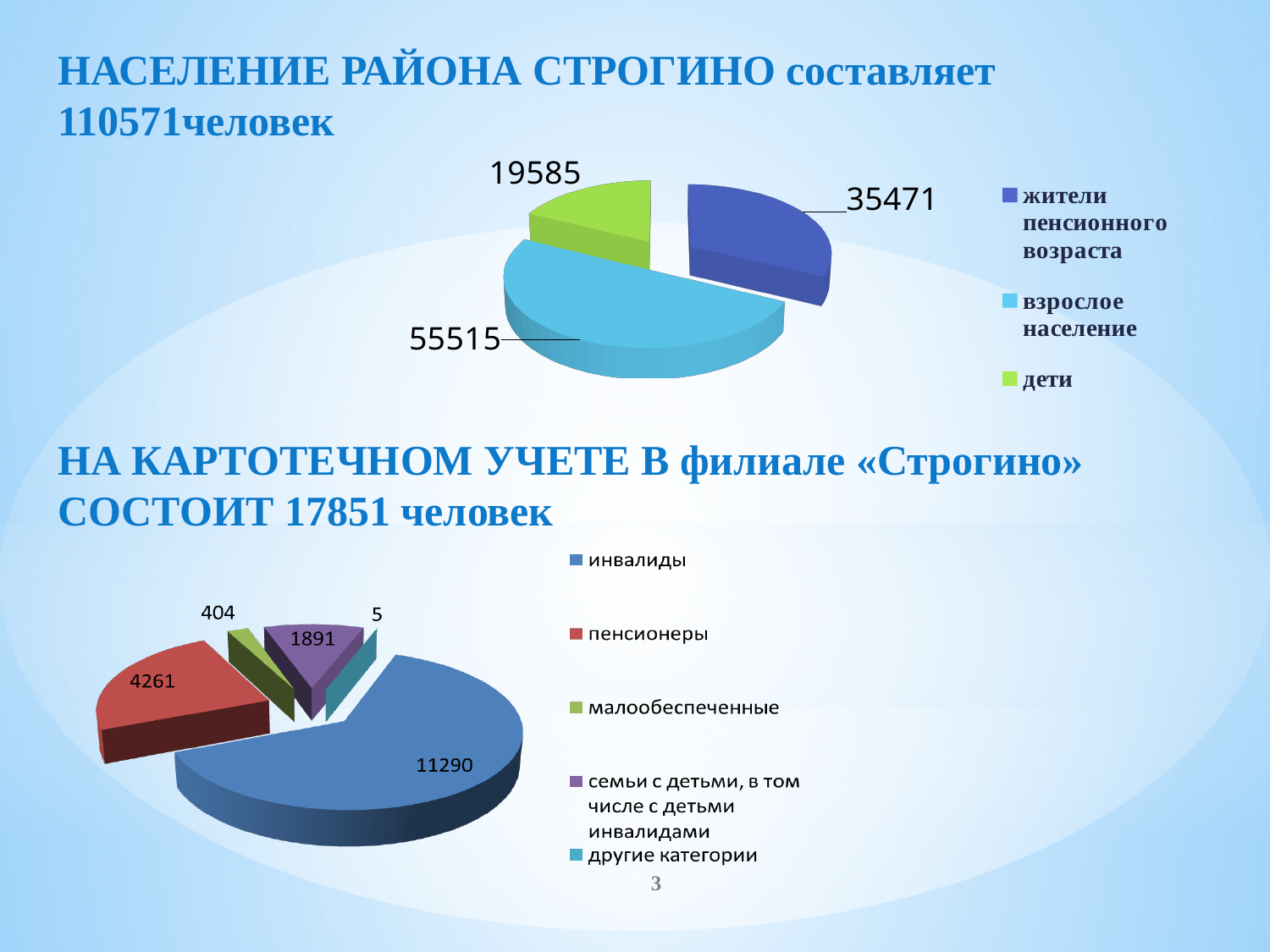
What type of chart is used for the population of Strogino district at the top of the slide? pie chart In the top pie chart (population of Strogino district), how many categories does the legend list? 3 In the top pie chart (population of Strogino district), what is the difference between жители пенсионного возраста and дети? 15886 In the bottom pie chart (people registered at the Strogino branch), how many categories are shown? 5 In the bottom pie chart (people registered at the Strogino branch), which category has the smallest slice? другие категории In the bottom pie chart (people registered at the Strogino branch), what is the difference between инвалиды and пенсионеры? 7029 In the bottom pie chart (people registered at the Strogino branch), what is the value for семьи с детьми, в том числе с детьми инвалидами? 1891 In the bottom pie chart (people registered at the Strogino branch), which is larger: инвалиды or пенсионеры? инвалиды In the bottom pie chart (people registered at the Strogino branch), what is the value for пенсионеры? 4261 In the top pie chart (population of Strogino district), what is the value for взрослое население? 55515 In the top pie chart (population of Strogino district), what is the value for дети? 19585 In the top pie chart (population of Strogino district), which category has the largest slice? взрослое население